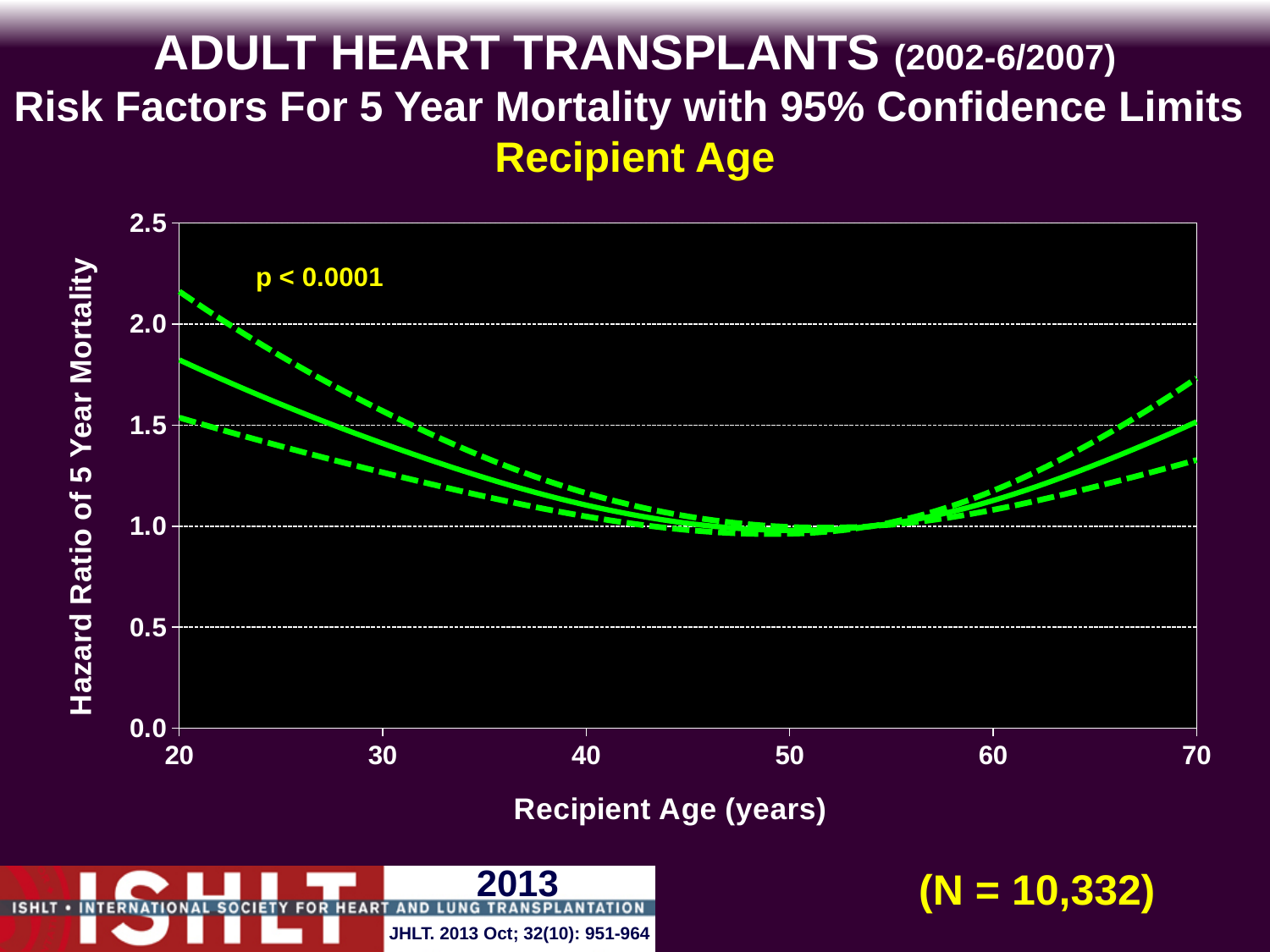
What p-value is shown on the chart? p < 0.0001 Is the hazard ratio (solid line) at recipient age 50 greater or less than 1.5? less Does the hazard ratio of 5 year mortality rise or fall as recipient age increases from 55 to 70 years? rise What kind of chart is shown on the slide? line chart Is the upper confidence limit (upper dashed line) at recipient age 20 greater or less than 2.0? greater Is the hazard ratio (solid line) higher at recipient age 20 or at recipient age 70? age 20 Is the hazard ratio (solid line) at recipient age 20 greater or less than 1.5? greater How many lines are plotted on the chart? 3 Does the hazard ratio of 5 year mortality rise or fall as recipient age increases from 20 to 50 years? fall What is the sample size (N) shown on the slide? N = 10,332